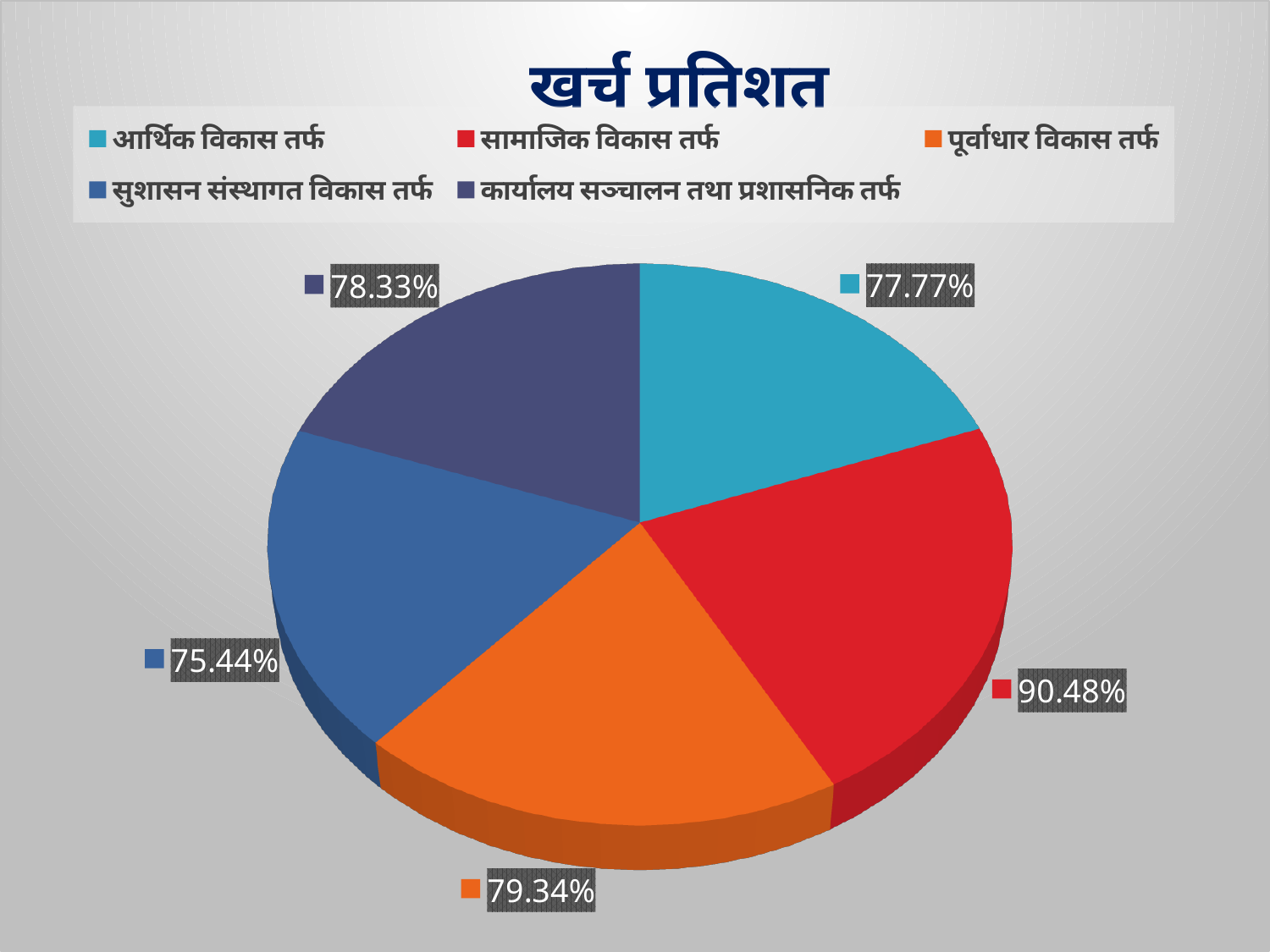
What is the value shown for पूर्वाधार विकास तर्फ? 79.34% Which category has the lowest value? सुशासन संस्थागत विकास तर्फ Which is larger, the value for पूर्वाधार विकास तर्फ or the value for आर्थिक विकास तर्फ? पूर्वाधार विकास तर्फ Which category has the highest value? सामाजिक विकास तर्फ What is the value shown for आर्थिक विकास तर्फ? 77.77% What is the value shown for सुशासन संस्थागत विकास तर्फ? 75.44% What is the title of the chart? खर्च प्रतिशत What kind of chart is shown on the slide? Pie chart What is the value shown for सामाजिक विकास तर्फ? 90.48% What is the value shown for कार्यालय सञ्चालन तथा प्रशासनिक तर्फ? 78.33% What is the difference between the values for सामाजिक विकास तर्फ and सुशासन संस्थागत विकास तर्फ? 15.04% How many categories are shown in the pie chart? 5